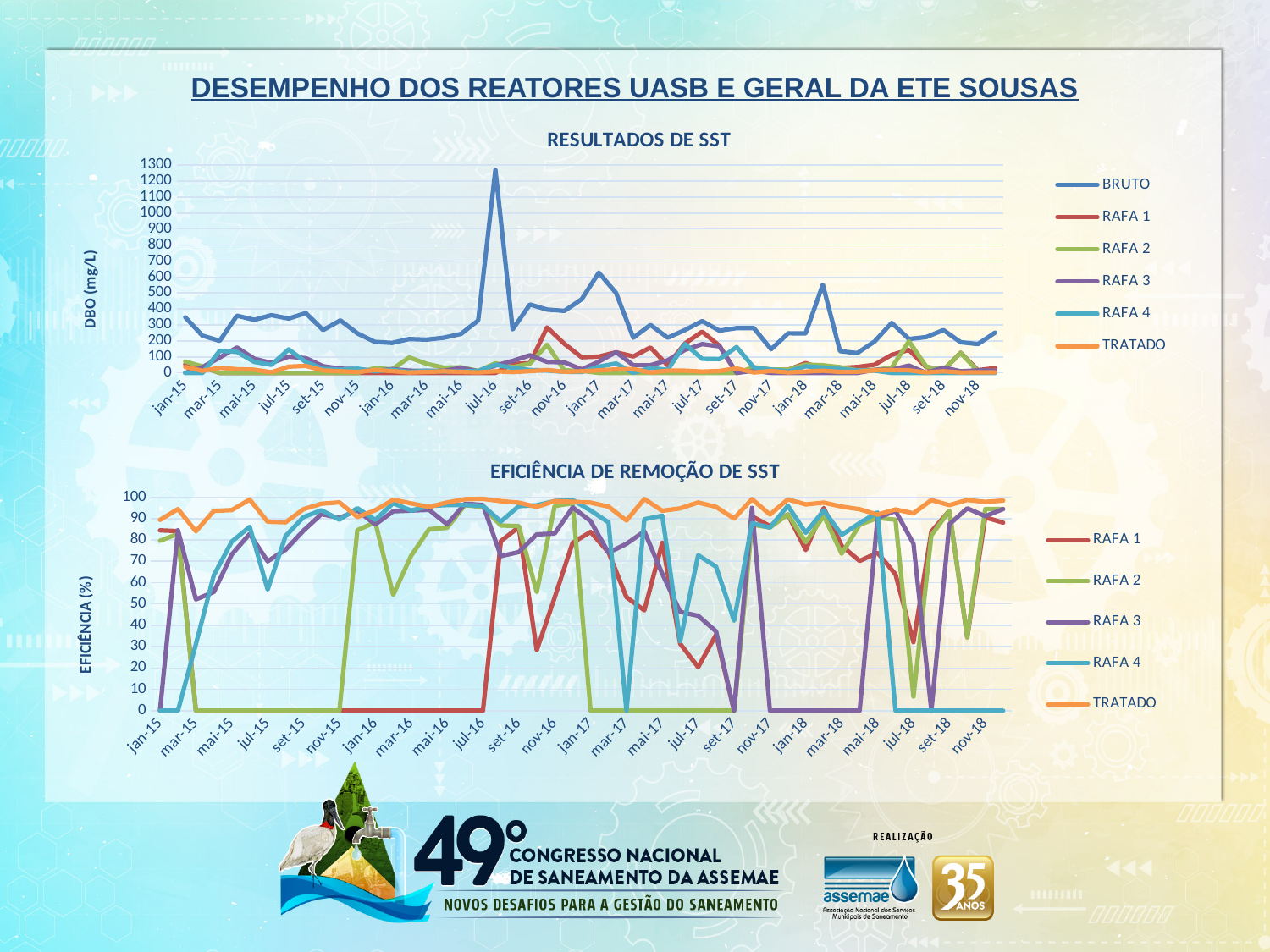
What type of chart is the top chart titled 'RESULTADOS DE SST'? line chart In the top chart 'RESULTADOS DE SST', is the BRUTO value at jan-15 greater or less than 200? greater In the top chart 'RESULTADOS DE SST', is the BRUTO value at jul-16 greater or less than 1000? greater In the top chart 'RESULTADOS DE SST', which series reaches the highest value? BRUTO In the bottom chart 'EFICIÊNCIA DE REMOÇÃO DE SST', which is larger at mar-16, RAFA 2 or TRATADO? TRATADO In the bottom chart 'EFICIÊNCIA DE REMOÇÃO DE SST', is the RAFA 1 value at mar-16 greater or less than 10? less In the top chart 'RESULTADOS DE SST', which is larger at jul-16, BRUTO or TRATADO? BRUTO What is the y-axis label of the top chart 'RESULTADOS DE SST'? DBO (mg/L) In the top chart 'RESULTADOS DE SST', in which month does the BRUTO series reach its peak? jul-16 How many series does the legend of the bottom chart 'EFICIÊNCIA DE REMOÇÃO DE SST' list? 5 What is the y-axis label of the bottom chart 'EFICIÊNCIA DE REMOÇÃO DE SST'? EFICIÊNCIA (%) How many series does the legend of the top chart 'RESULTADOS DE SST' list? 6